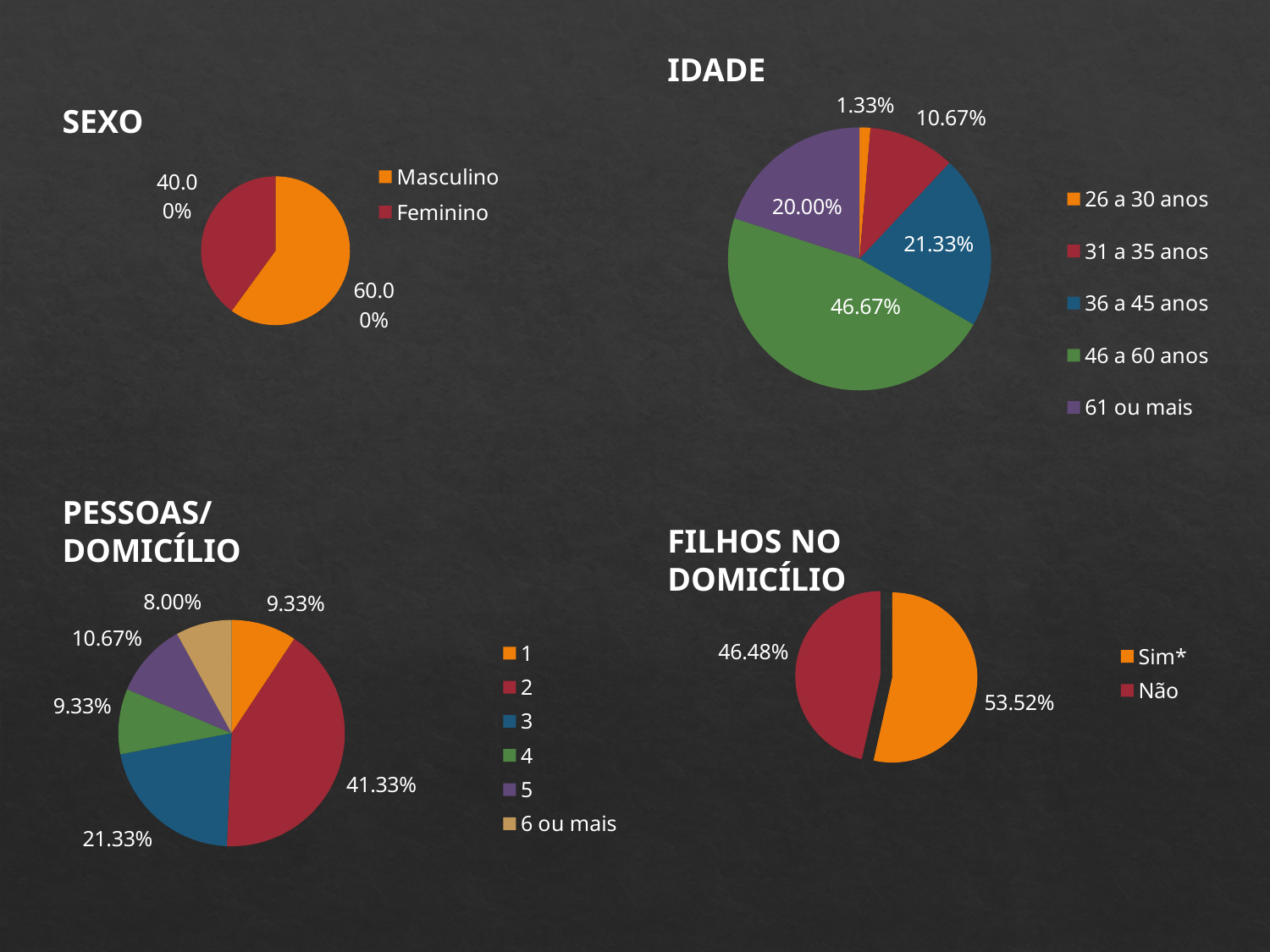
What kind of chart is the FILHOS NO DOMICÍLIO chart? Pie chart In the IDADE chart, which age group has the largest share? 46 a 60 anos In the IDADE chart, what is the share for 36 a 45 anos? 21.33% In the FILHOS NO DOMICÍLIO chart, which is larger, Sim* or Não? Sim* In the IDADE chart, what is the difference between the shares of 46 a 60 anos and 61 ou mais? 26.67% In the PESSOAS/DOMICÍLIO chart, what is the share for 3? 21.33% In the SEXO chart, what share is Feminino? 40.00% In the IDADE chart, which age group has the smallest share? 26 a 30 anos In the SEXO chart, what share is Masculino? 60.00% In the PESSOAS/DOMICÍLIO chart, what is the share for 6 ou mais? 8.00% How many categories does the legend of the IDADE chart list? 5 In the PESSOAS/DOMICÍLIO chart, which category has the largest share? 2